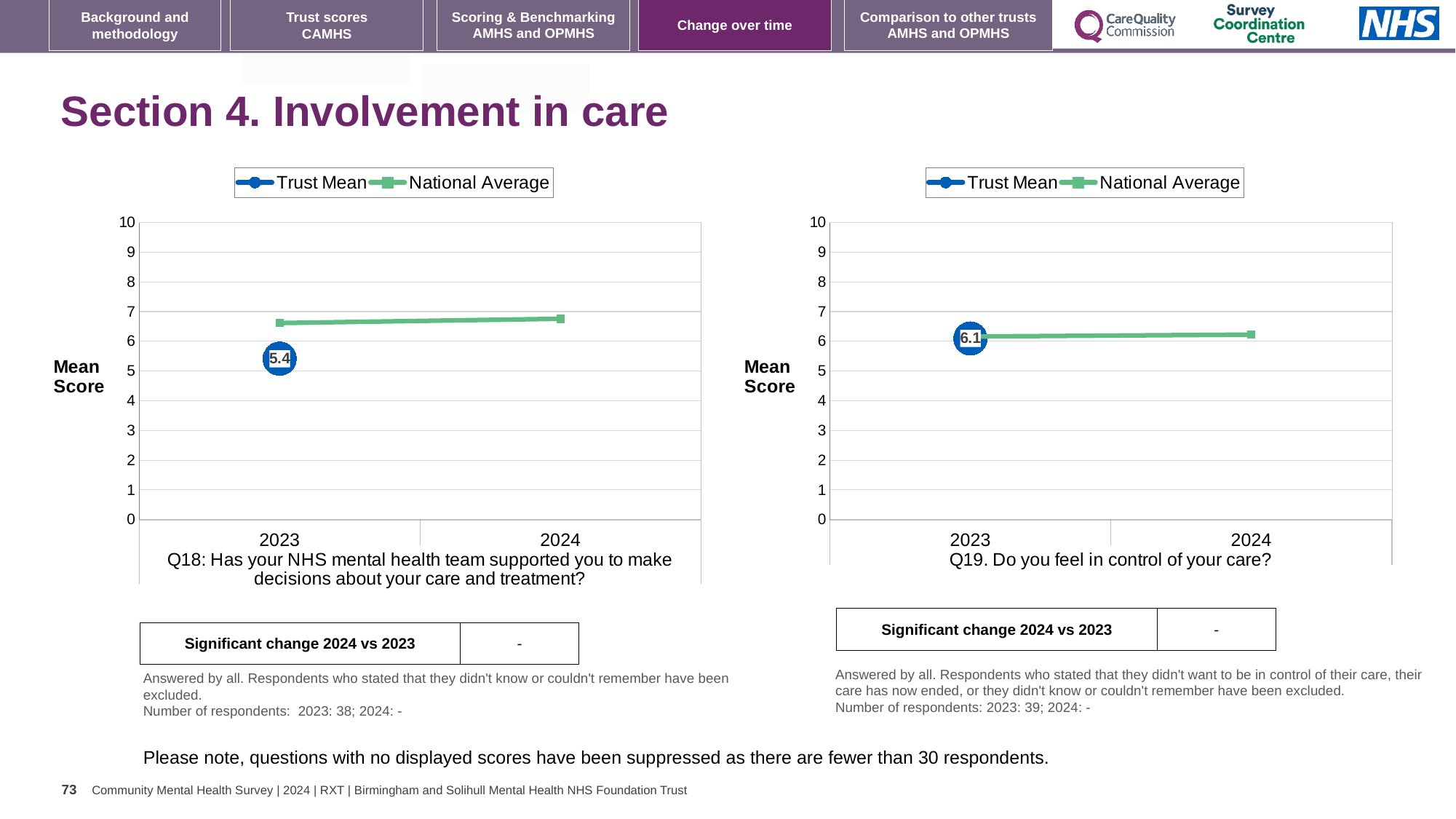
What is the y-axis label on the right chart (Q19)? Mean Score What kind of chart is the left chart (Q18)? Line chart How many years are shown on the x axis of the left chart (Q18)? 2 In the left chart (Q18), is the National Average for 2023 greater or less than 6? greater In the right chart (Q19), is the National Average for 2024 greater or less than 5? greater In the left chart (Q18), what is the Trust Mean score for 2023? 5.4 Which of the two charts shows the higher Trust Mean for 2023? The right chart (Q19) How many series does the legend of the right chart (Q19) list? 2 What are the two series named in the legend of the left chart (Q18)? Trust Mean and National Average In the right chart (Q19), what is the Trust Mean score for 2023? 6.1 In the left chart (Q18), which is higher for 2023: the Trust Mean or the National Average? National Average In the left chart (Q18), is the National Average for 2024 greater or less than 7? less